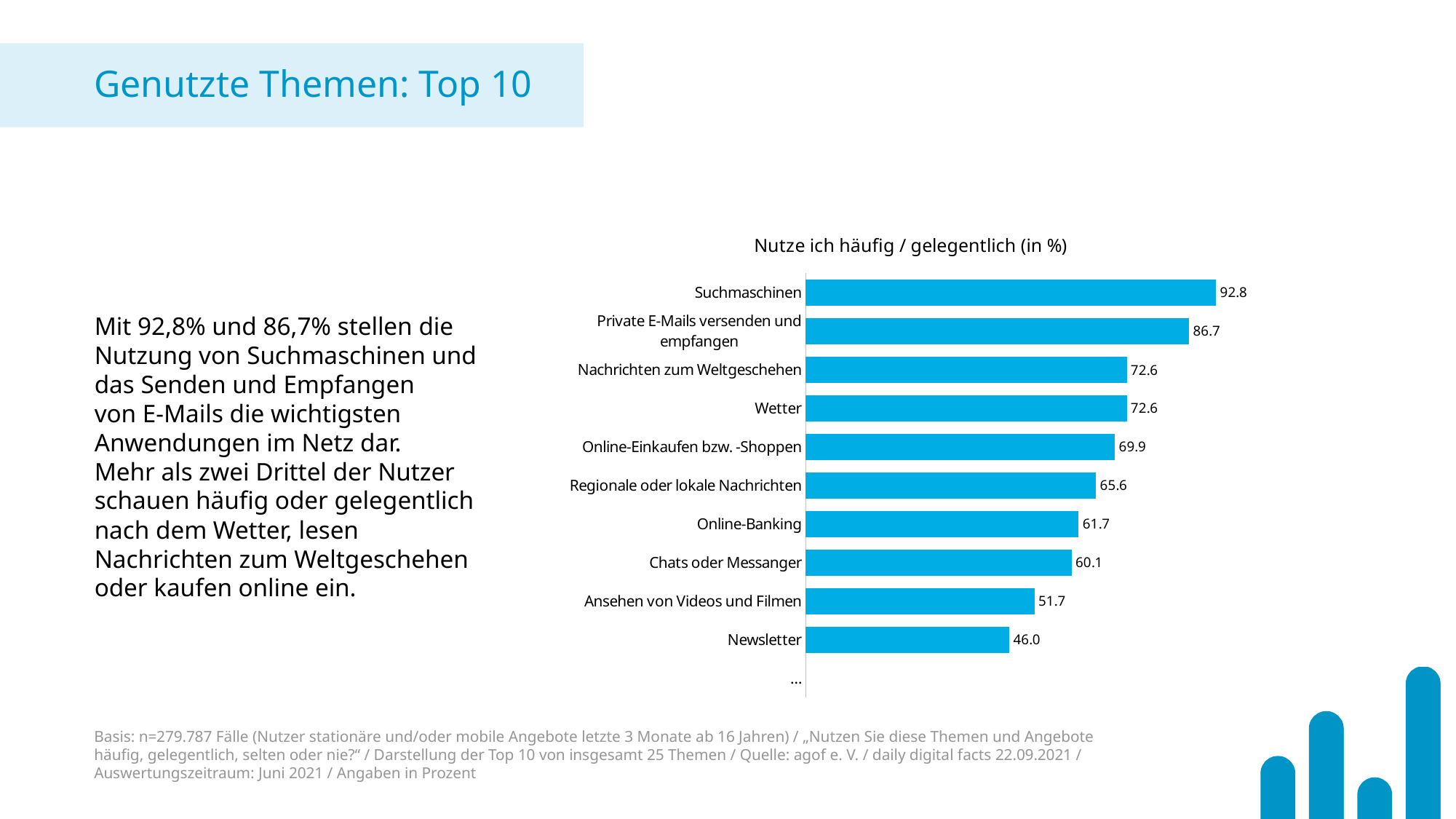
Which is larger, the value for Online-Einkaufen bzw. -Shoppen or the value for Chats oder Messanger? Online-Einkaufen bzw. -Shoppen What is the value for Regionale oder lokale Nachrichten? 65.6 Which labelled category has the lowest value? Newsletter How many labelled categories with bars are shown in the chart? 10 What is the value for Suchmaschinen? 92.8 What is the value for Newsletter? 46.0 What is the value for Online-Banking? 61.7 Which category has the highest value? Suchmaschinen What kind of chart is shown on the slide? Bar chart What is the title of the chart? Nutze ich häufig / gelegentlich (in %) What is the difference between the values for Suchmaschinen and Private E-Mails versenden und empfangen? 6.1 What is the difference between the values for Ansehen von Videos und Filmen and Newsletter? 5.7